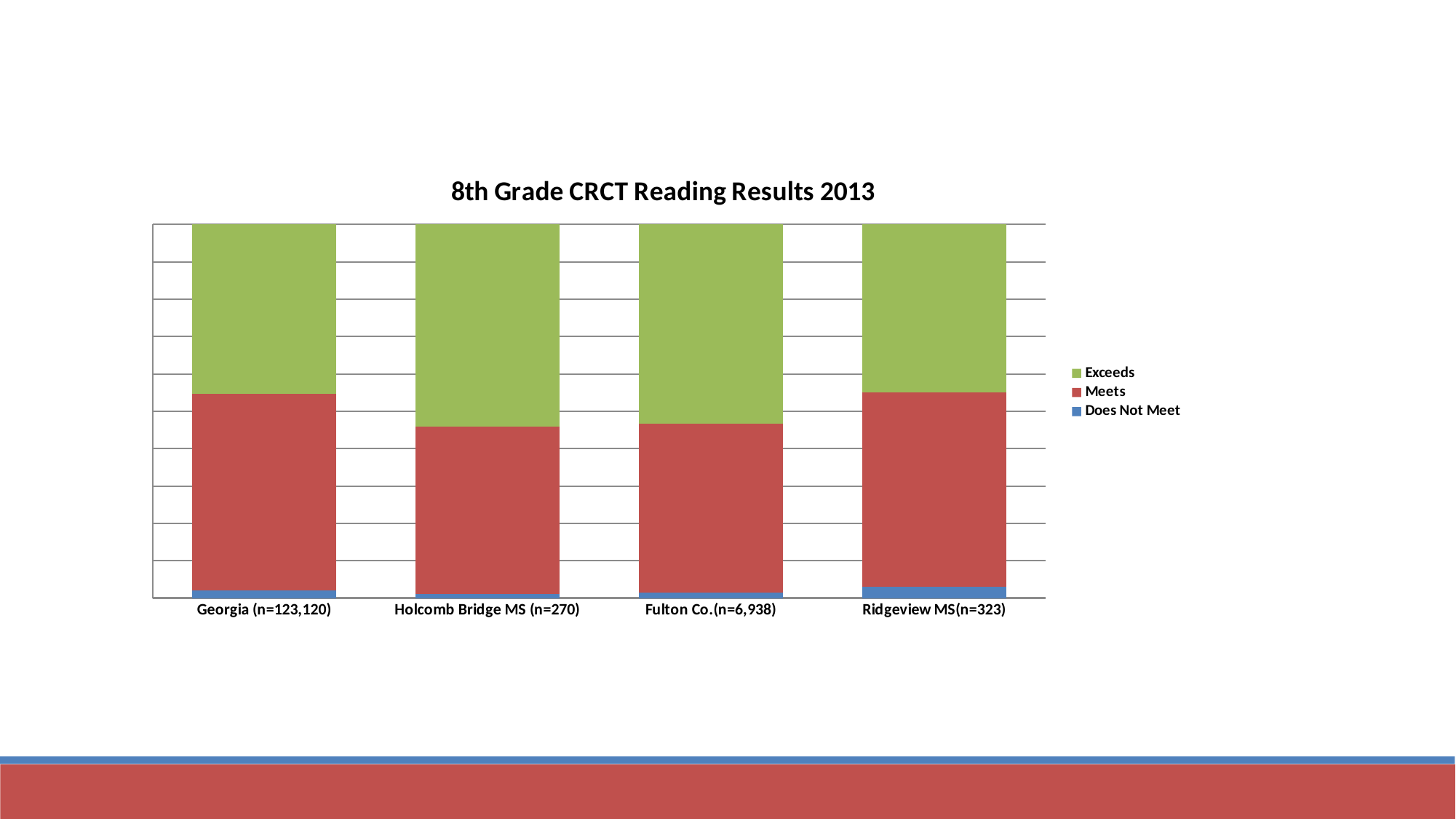
Which category has the largest Does Not Meet segment? Ridgeview MS(n=323) What kind of chart is shown on the slide? Stacked bar chart What is the title of the chart? 8th Grade CRCT Reading Results 2013 How many series does the legend list? 3 Is the Exceeds segment larger for Fulton Co.(n=6,938) or for Ridgeview MS(n=323)? Fulton Co.(n=6,938) Which series is shown in green? Exceeds How many categories are shown on the x axis? 4 Is the Meets segment larger for Georgia (n=123,120) or for Holcomb Bridge MS (n=270)? Georgia (n=123,120) Is the Exceeds segment larger for Holcomb Bridge MS (n=270) or for Georgia (n=123,120)? Holcomb Bridge MS (n=270)